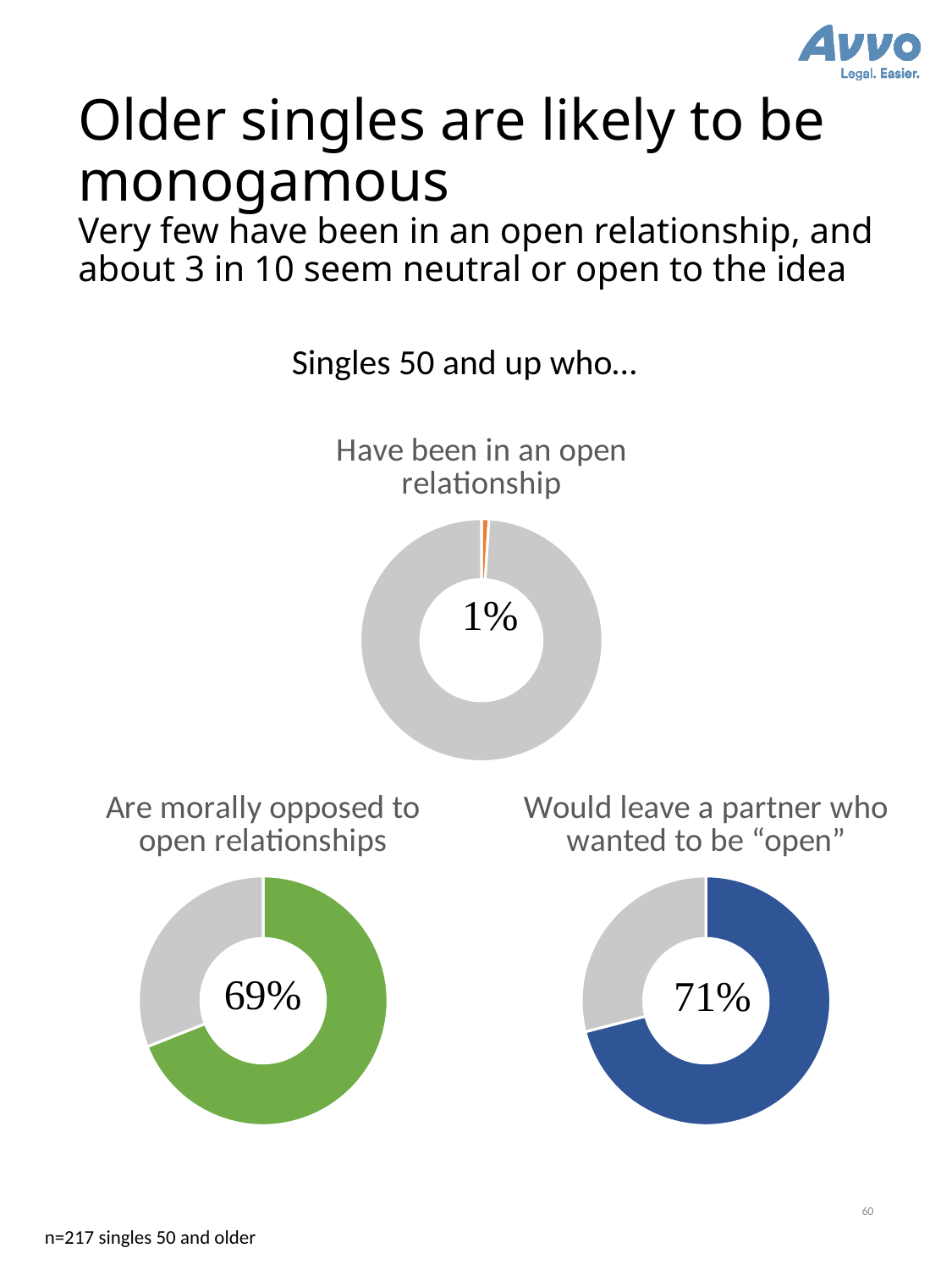
What is the difference in percentage points between the "Would leave a partner who wanted to be "open"" chart and the "Are morally opposed to open relationships" chart? 2 percentage points Which of the three charts shows the highest percentage? Would leave a partner who wanted to be "open" In the chart titled "Are morally opposed to open relationships", what percentage is shown? 69% Which of the three charts shows the lowest percentage? Have been in an open relationship What is the heading above the three charts? Singles 50 and up who… What colour is the highlighted slice in the "Are morally opposed to open relationships" chart? Green In the chart titled "Would leave a partner who wanted to be "open"", what percentage is shown? 71% Which is larger: the percentage who are morally opposed to open relationships or the percentage who would leave a partner who wanted to be "open"? Would leave a partner who wanted to be "open" What kind of chart is used for the three charts on the slide? Donut (pie) chart What is the difference in percentage points between the "Are morally opposed to open relationships" chart and the "Have been in an open relationship" chart? 68 percentage points How many donut charts are shown on the slide? 3 In the chart titled "Have been in an open relationship", what percentage is shown? 1%